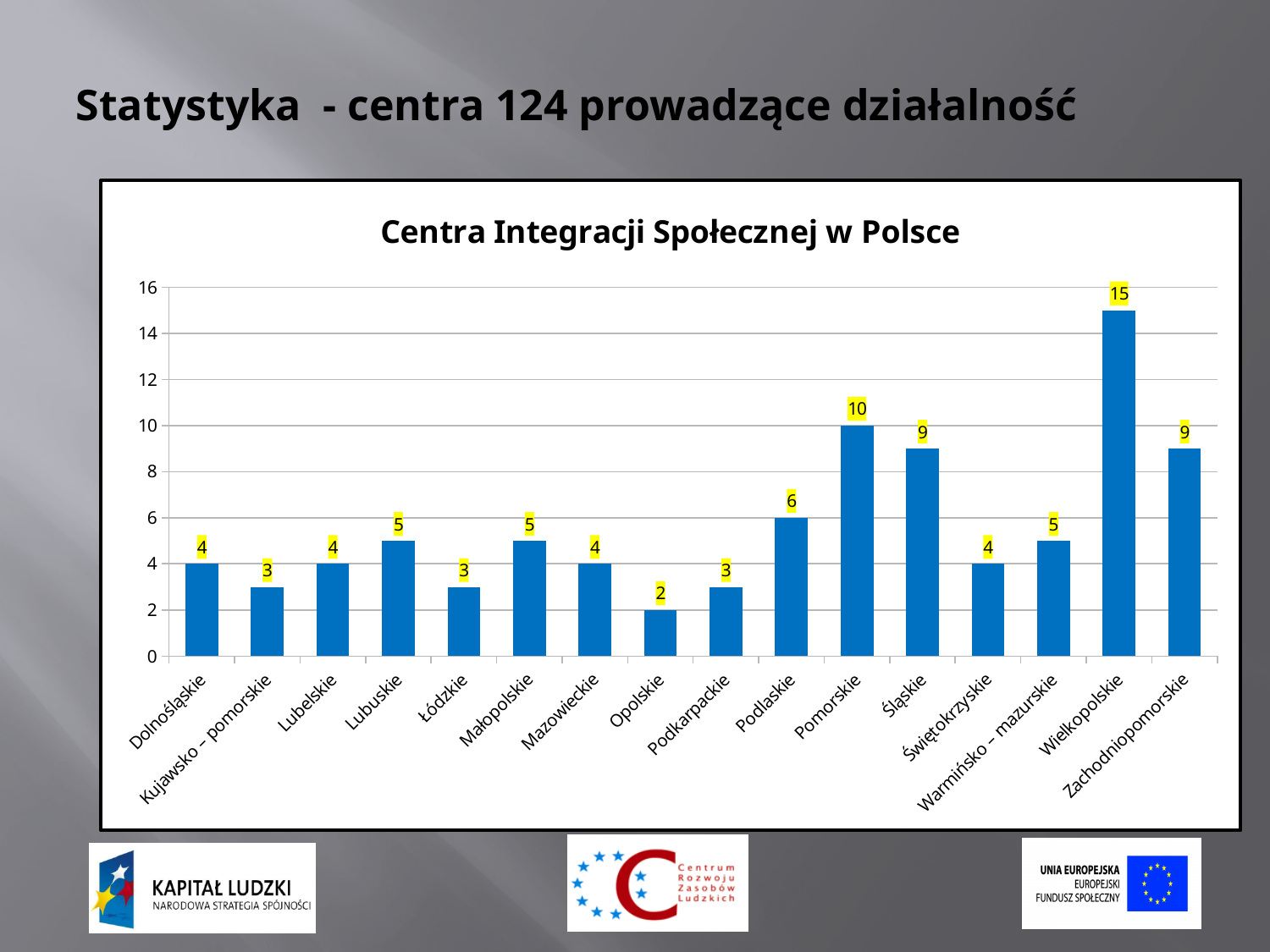
Which category has the highest value? Wielkopolskie What is the difference between the values for Zachodniopomorskie and Łódzkie? 6 How many categories are shown on the x axis? 16 What is the title of the chart? Centra Integracji Społecznej w Polsce Which is larger, the value for Podlaskie or the value for Lubuskie? Podlaskie What is the difference between the values for Wielkopolskie and Pomorskie? 5 What is the value for Wielkopolskie? 15 What is the value for Opolskie? 2 Is the value for Śląskie greater or less than 8? greater What is the value for Pomorskie? 10 What kind of chart is this? bar chart Which category has the lowest value? Opolskie